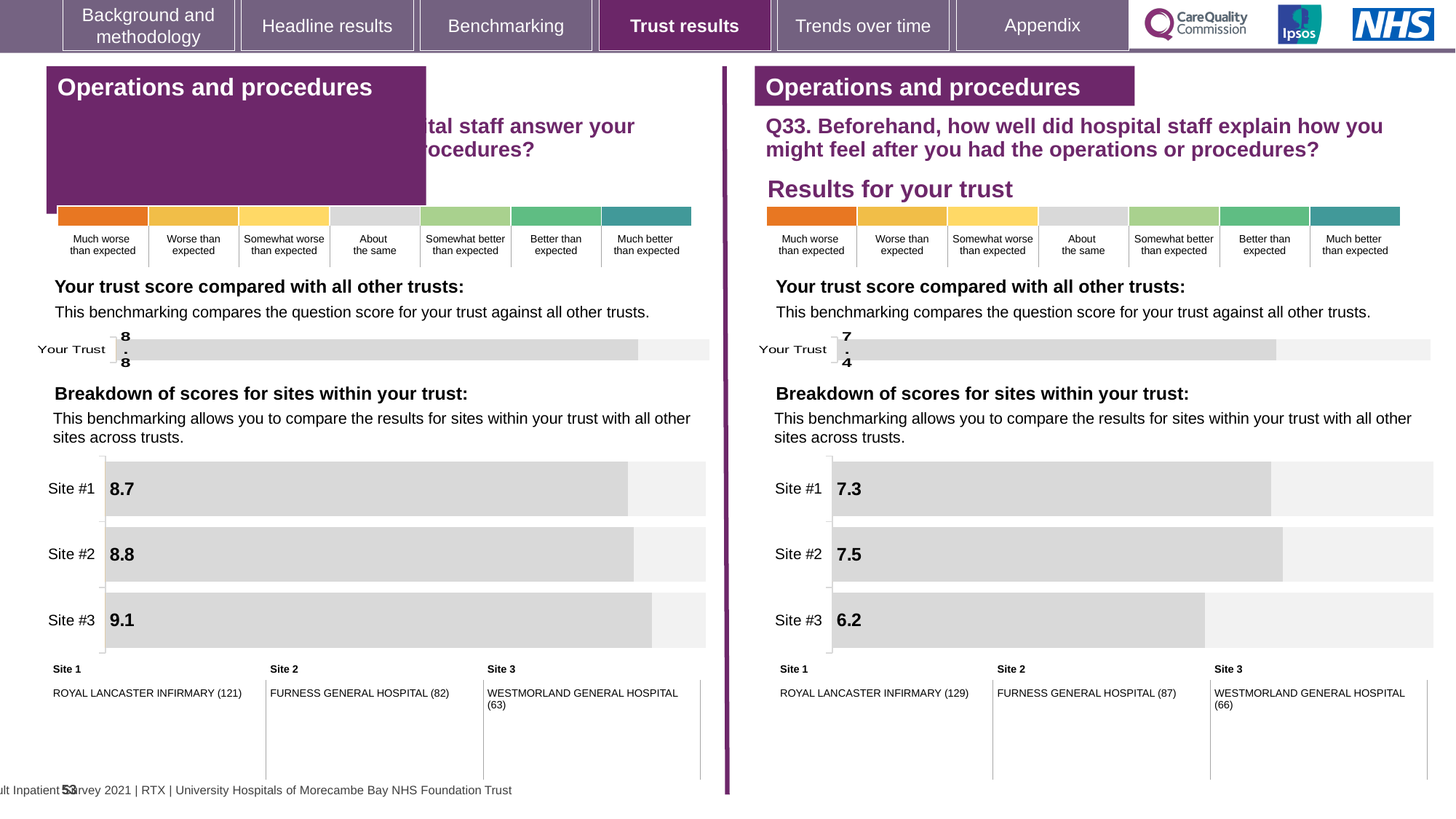
On the left-hand site breakdown chart, what is the score for Site #3? 9.1 On the Q33 site breakdown chart on the right, which site has the lowest score? Site #3 On the left-hand site breakdown chart, which site has the highest score? Site #3 On the Q33 site breakdown chart on the right, what is the score for Site #2? 7.5 On the left-hand site breakdown chart, do the scores rise or fall from Site #1 to Site #3? Rise On the Q33 site breakdown chart on the right, what is the difference between the scores for Site #2 and Site #3? 1.3 How many sites are shown on the left-hand site breakdown chart? 3 On the left-hand 'Your trust score compared with all other trusts' chart, what is the score shown for Your Trust? 8.8 On the left-hand site breakdown chart, what is the difference between the scores for Site #3 and Site #1? 0.4 On the Q33 'Your trust score compared with all other trusts' chart on the right, what is the score shown for Your Trust? 7.4 On the Q33 site breakdown chart on the right, which has the higher score, Site #1 or Site #2? Site #2 What type of chart is the Q33 site breakdown chart on the right? Bar chart